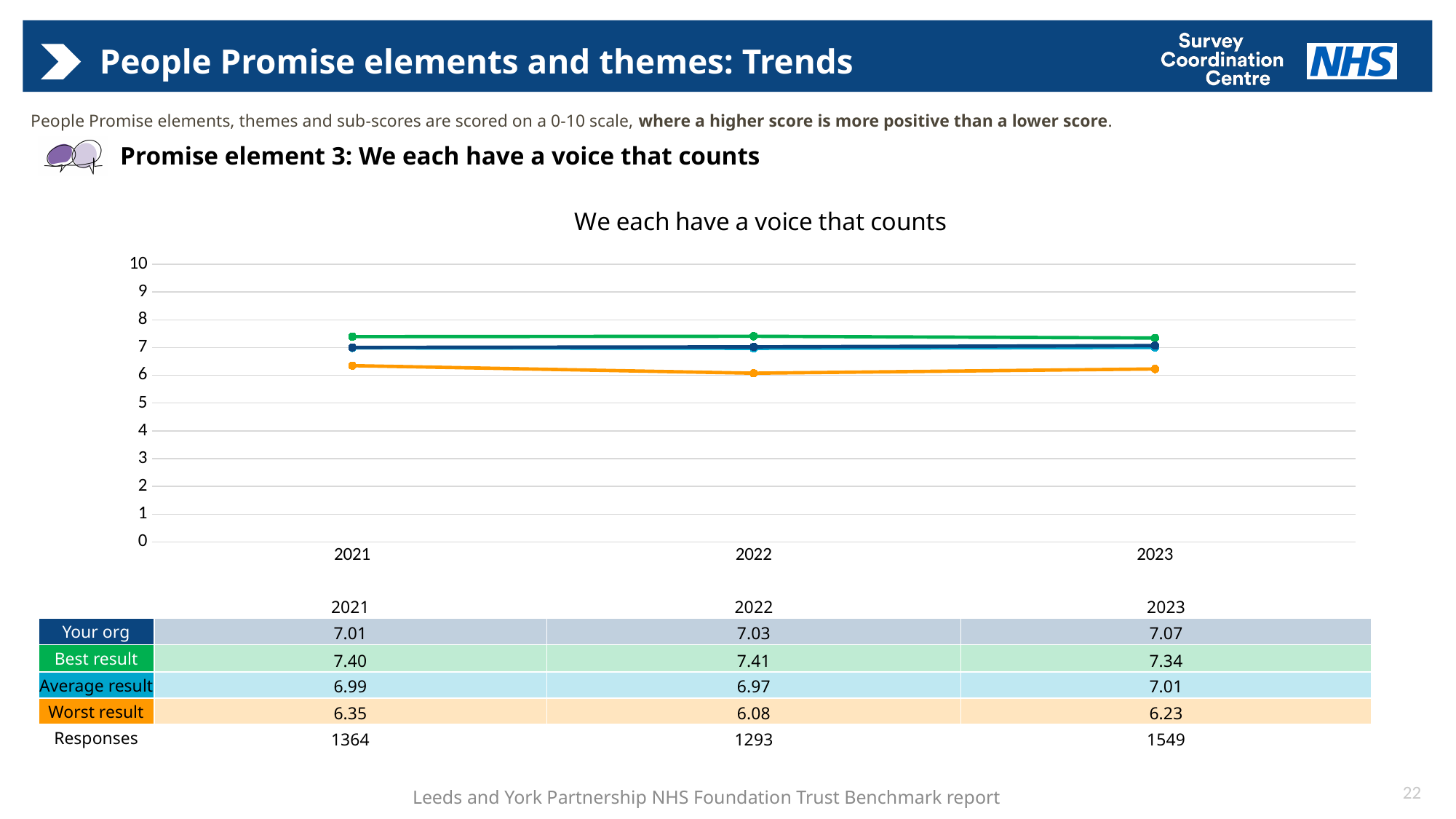
In which year is the Worst result score lowest? 2022 Does the Your org score rise or fall from 2021 to 2023? rises Which is larger in 2022, the Your org score or the Average result score? Your org What is the Your org score for 2023? 7.07 What kind of chart is shown on the slide? line chart How many years are shown on the x axis of the chart? 3 What is the difference between the Best result and Your org scores in 2023? 0.27 What is the Best result score for 2021? 7.40 What is the Worst result score for 2022? 6.08 Is the Worst result value for 2021 greater or less than 7? less In which year is the Your org score highest? 2023 How many series are plotted in the chart? 4